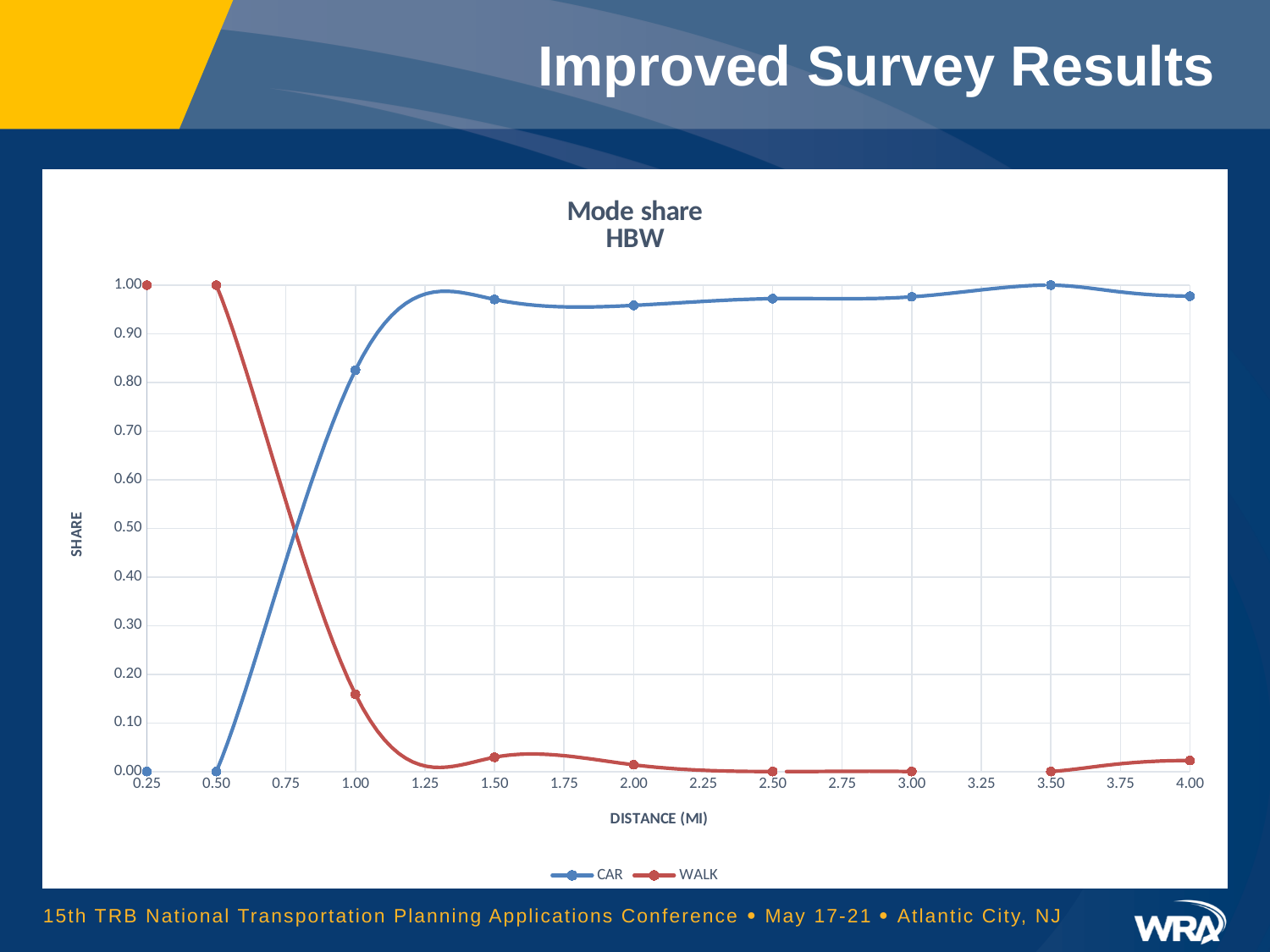
At a distance of 1.00 miles, which series has the larger share, CAR or WALK? CAR What kind of chart is shown on the slide? line chart How many data points are plotted for the CAR series? 9 What is the WALK share at a distance of 3.00 miles? 0.00 What is the WALK share at a distance of 0.25 miles? 1.00 How many series does the legend list? 2 Is the CAR share at 2.00 miles greater or less than 0.90? greater What is the CAR share at a distance of 0.50 miles? 0.00 Is the CAR share at 1.00 miles greater or less than 0.70? greater What is the label of the x axis? DISTANCE (MI) Is the WALK share at 1.00 miles greater or less than 0.20? less Does the WALK share rise or fall as distance increases from 0.50 to 1.50 miles? fall